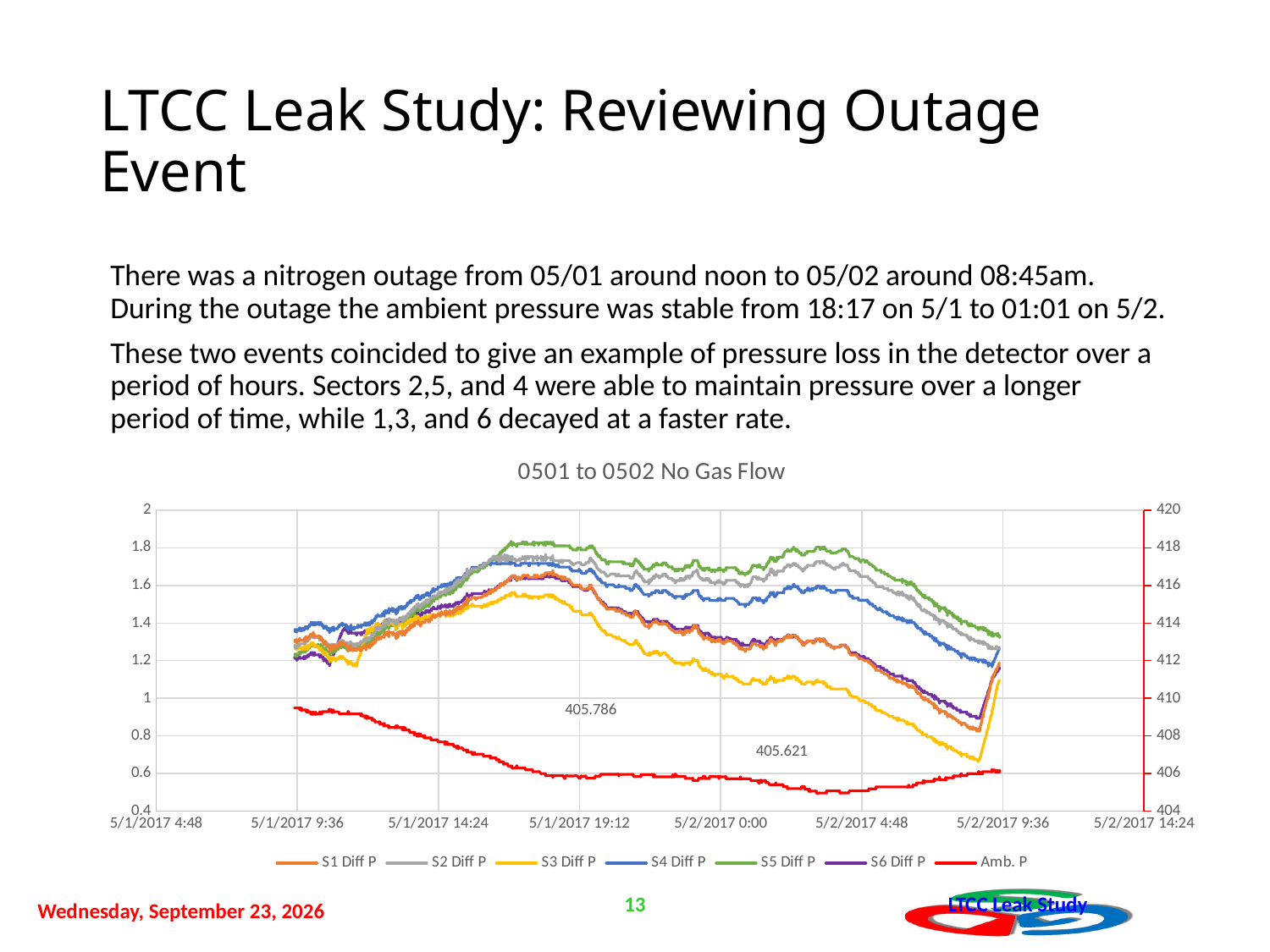
Is the value for S5 Diff P at 5/1/2017 19:12 greater or less than 1.6? greater At 5/2/2017 4:48, which is larger: S5 Diff P or S3 Diff P? S5 Diff P What is the title of the chart? 0501 to 0502 No Gas Flow Is the value for S3 Diff P at 5/2/2017 4:48 greater or less than 1.2? less What type of chart is shown on the slide? line chart What is the second data label printed on the Amb. P line? 405.621 What is the first data label printed on the Amb. P line? 405.786 Does the Amb. P line rise or fall between 5/1/2017 9:36 and 5/1/2017 19:12? fall Among the Diff P series, which one is lowest around 5/2/2017 4:48? S3 Diff P What colour is the Amb. P line in the legend? red How many series does the legend of the chart list? 7 Which series is plotted highest around 5/1/2017 19:12? S5 Diff P